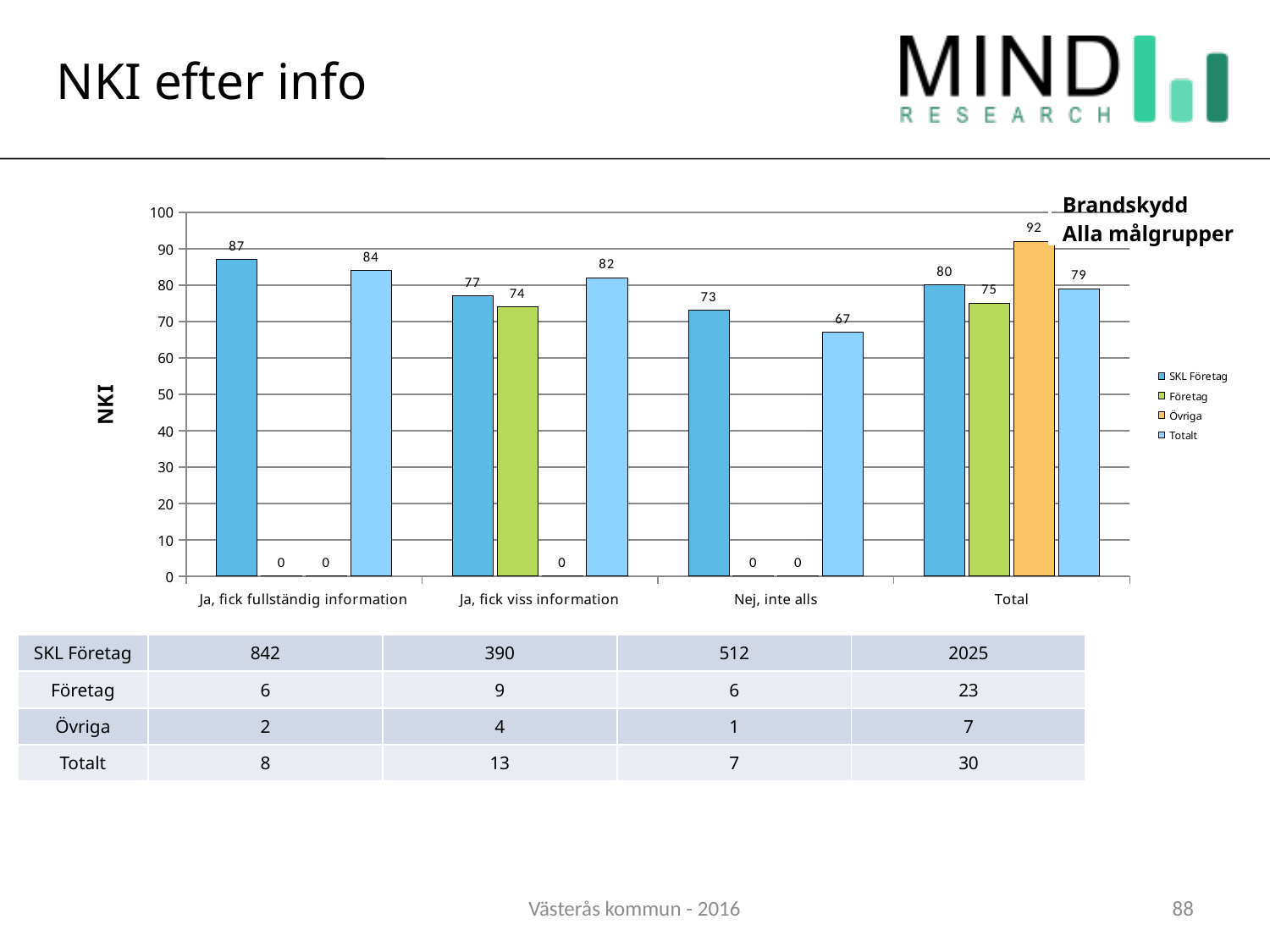
Which category has the lowest Totalt value? Nej, inte alls How many series does the legend list? 4 What is the NKI value for Företag in the 'Ja, fick viss information' category? 74 What kind of chart is shown on the slide? Bar chart What is the NKI value for Övriga in the 'Total' category? 92 What is the NKI value for Totalt in the 'Nej, inte alls' category? 67 Which category has the highest SKL Företag value? Ja, fick fullständig information How many categories are shown on the x axis? 4 What is the label on the vertical axis of the chart? NKI What is the NKI value for SKL Företag in the 'Ja, fick fullständig information' category? 87 Which is larger in the 'Total' category: the SKL Företag value or the Företag value? SKL Företag What is the difference between the SKL Företag value and the Totalt value in the 'Ja, fick viss information' category? 5